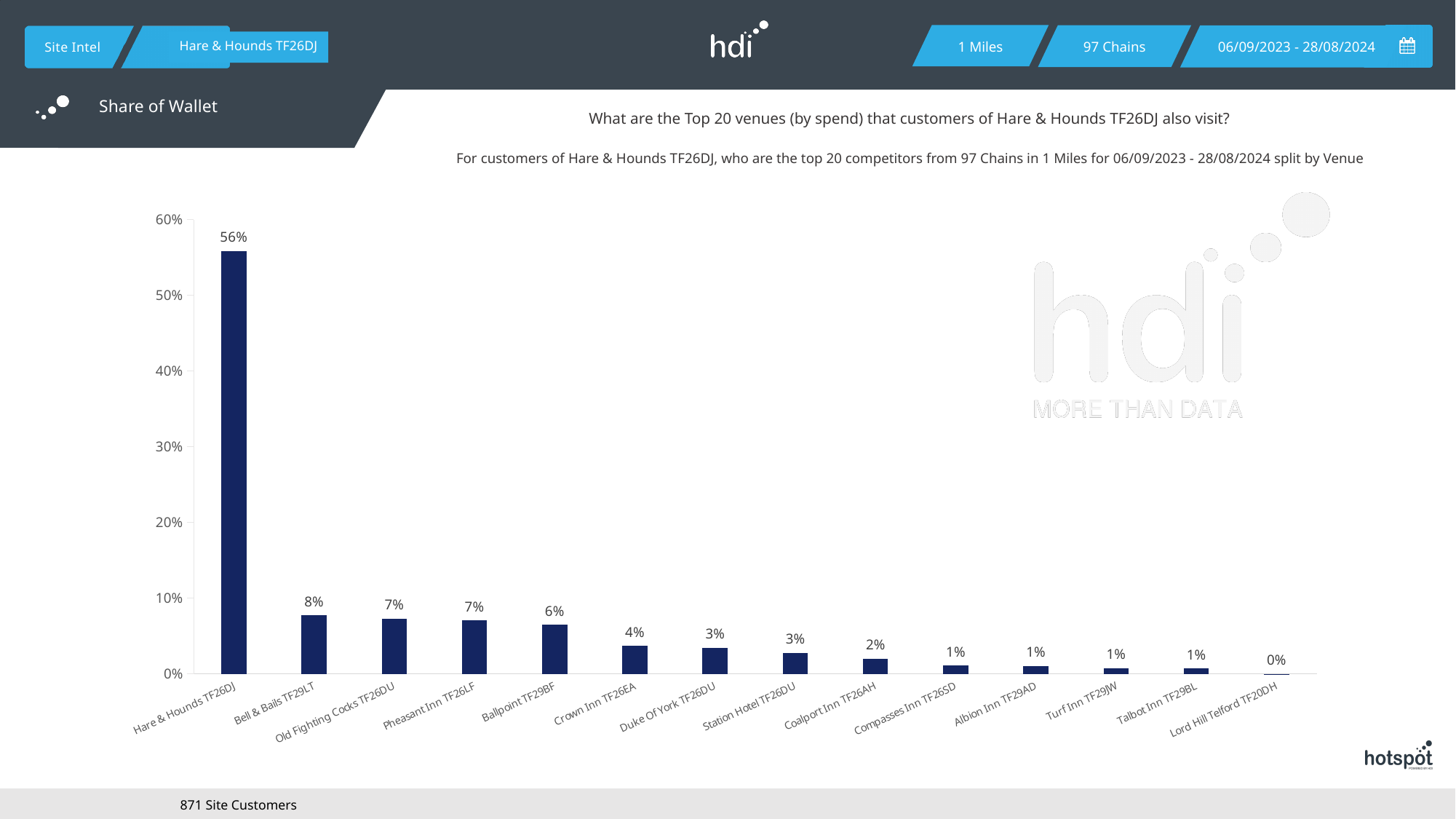
What is the value for Crown Inn TF26EA? 4% What is the difference between the values for Hare & Hounds TF26DJ and Bell & Bails TF29LT? 48% Which is larger, the value for Ballpoint TF29BF or the value for Duke Of York TF26DU? Ballpoint TF29BF How many venues are shown on the chart? 14 What is the value for Coalport Inn TF26AH? 2% Do the values generally rise or fall from left to right along the x axis? Fall Is the value for Hare & Hounds TF26DJ greater or less than 50%? greater What is the value for Hare & Hounds TF26DJ? 56% Which venue has the lowest value? Lord Hill Telford TF20DH Which venue has the highest value? Hare & Hounds TF26DJ What is the value for Bell & Bails TF29LT? 8% What kind of chart is shown on the slide? Bar chart